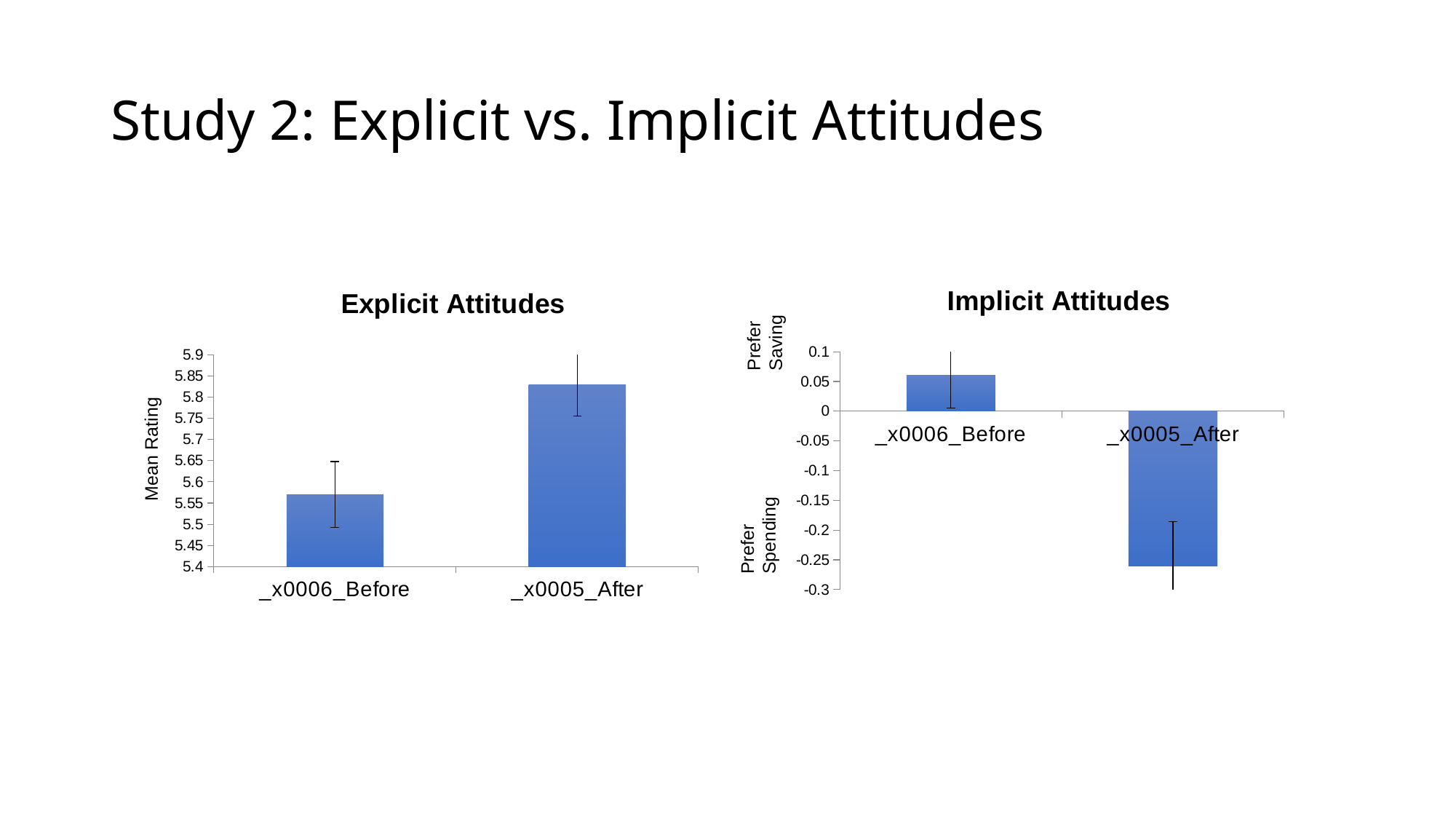
What type of chart is the Explicit Attitudes chart? bar chart In the Explicit Attitudes chart, is the value for _x0006_Before greater or less than 5.6? less In the Implicit Attitudes chart, is the value for _x0006_Before greater or less than 0? greater How many categories are shown in the Explicit Attitudes chart? 2 In the Implicit Attitudes chart, do the values rise or fall from _x0006_Before to _x0005_After? fall In the Implicit Attitudes chart, which category has the higher value, _x0006_Before or _x0005_After? _x0006_Before In the Explicit Attitudes chart, is the value for _x0006_Before greater or less than 5.5? greater In the Explicit Attitudes chart, which category has the lowest mean rating? _x0006_Before What is the y-axis label of the Explicit Attitudes chart? Mean Rating In the Explicit Attitudes chart, which category has the highest mean rating? _x0005_After